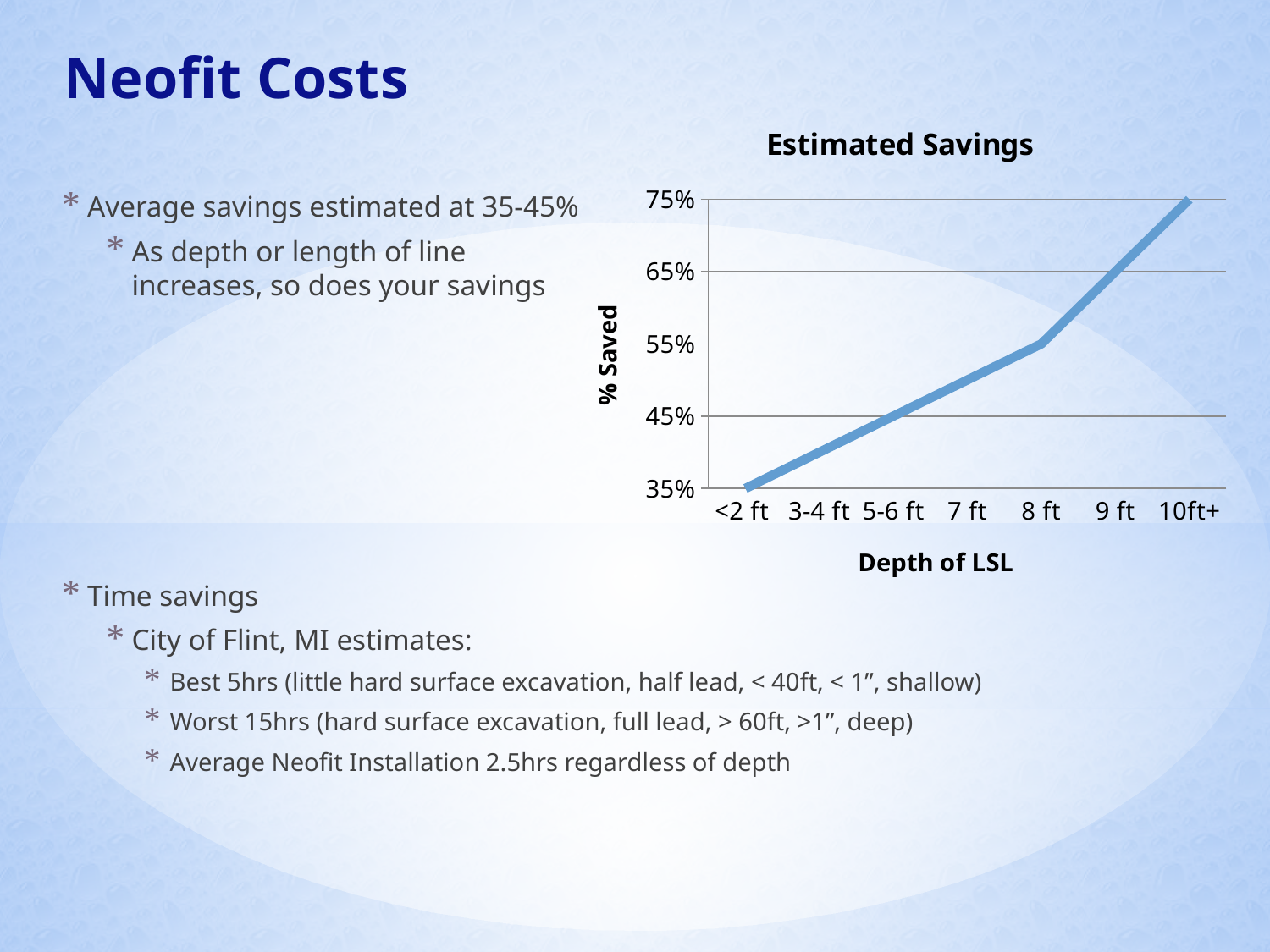
What is the label of the x axis of the chart? Depth of LSL Is the % Saved for 7 ft greater or less than 45%? greater What is the % Saved for the <2 ft depth category? 35% Does the % Saved rise or fall as the depth of LSL increases along the x axis? rises Which has a higher % Saved, 8 ft or 5-6 ft? 8 ft What is the title of the chart? Estimated Savings How many depth categories are shown on the x axis of the chart? 7 Is the % Saved for 3-4 ft greater or less than 45%? less Which depth category has the lowest % Saved? <2 ft Which depth category has the highest % Saved? 10ft+ What is the % Saved for the 10ft+ depth category? 75% What kind of chart is shown on the slide? line chart